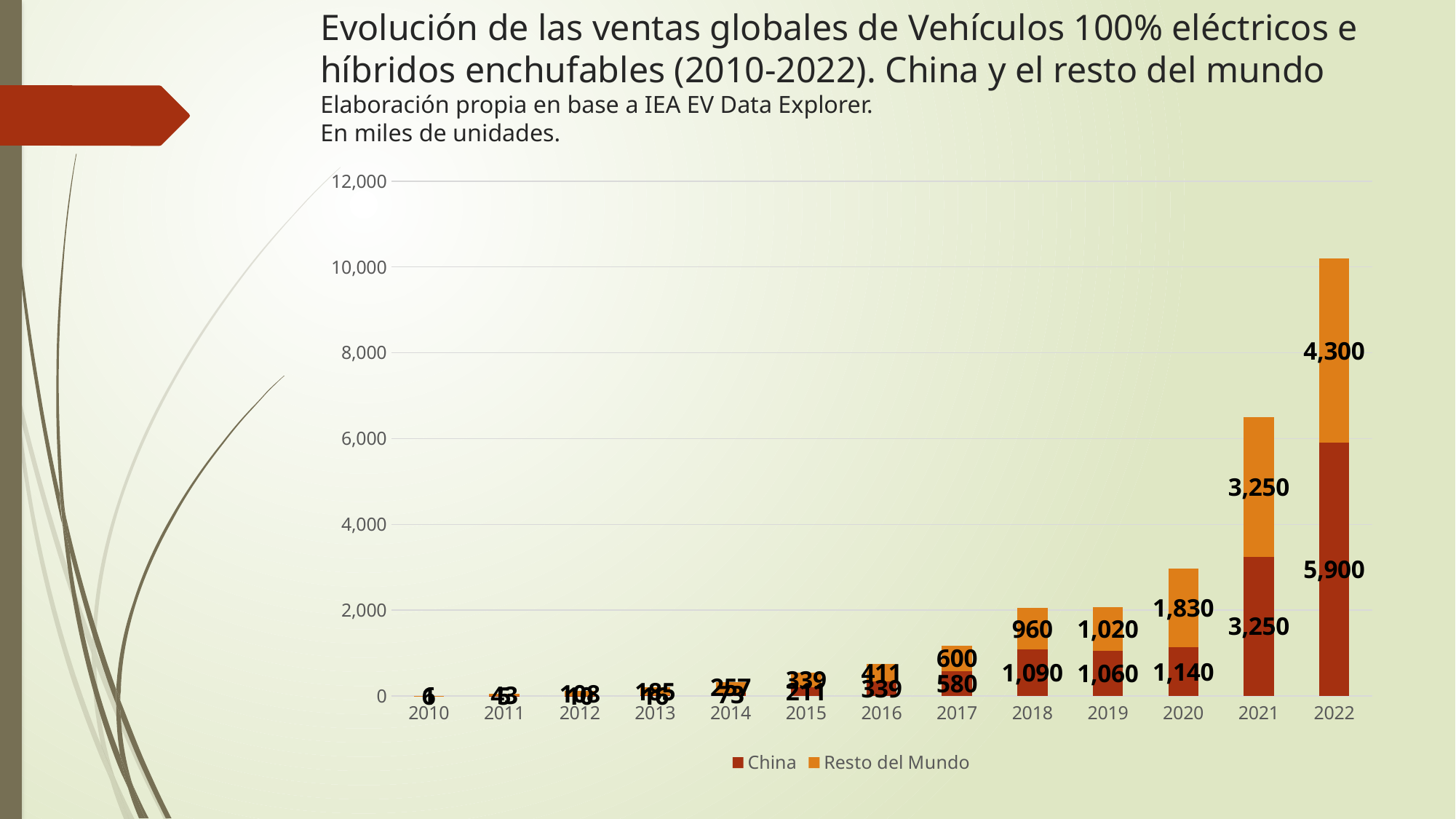
What is the value for China in 2020? 1,140 What is the value for Resto del Mundo in 2018? 960 What kind of chart is shown on the slide? stacked bar chart What is the difference between China and Resto del Mundo in 2020? 690 Which year has the highest total stacked bar? 2022 What is the total of the stacked bar for 2021? 6,500 What is the value for Resto del Mundo in 2022? 4,300 Which is larger in 2019, China or Resto del Mundo? China What is the total of the stacked bar for 2022? 10,200 What is the value for China in 2022? 5,900 How many series does the legend list? 2 How many years are shown on the x axis? 13